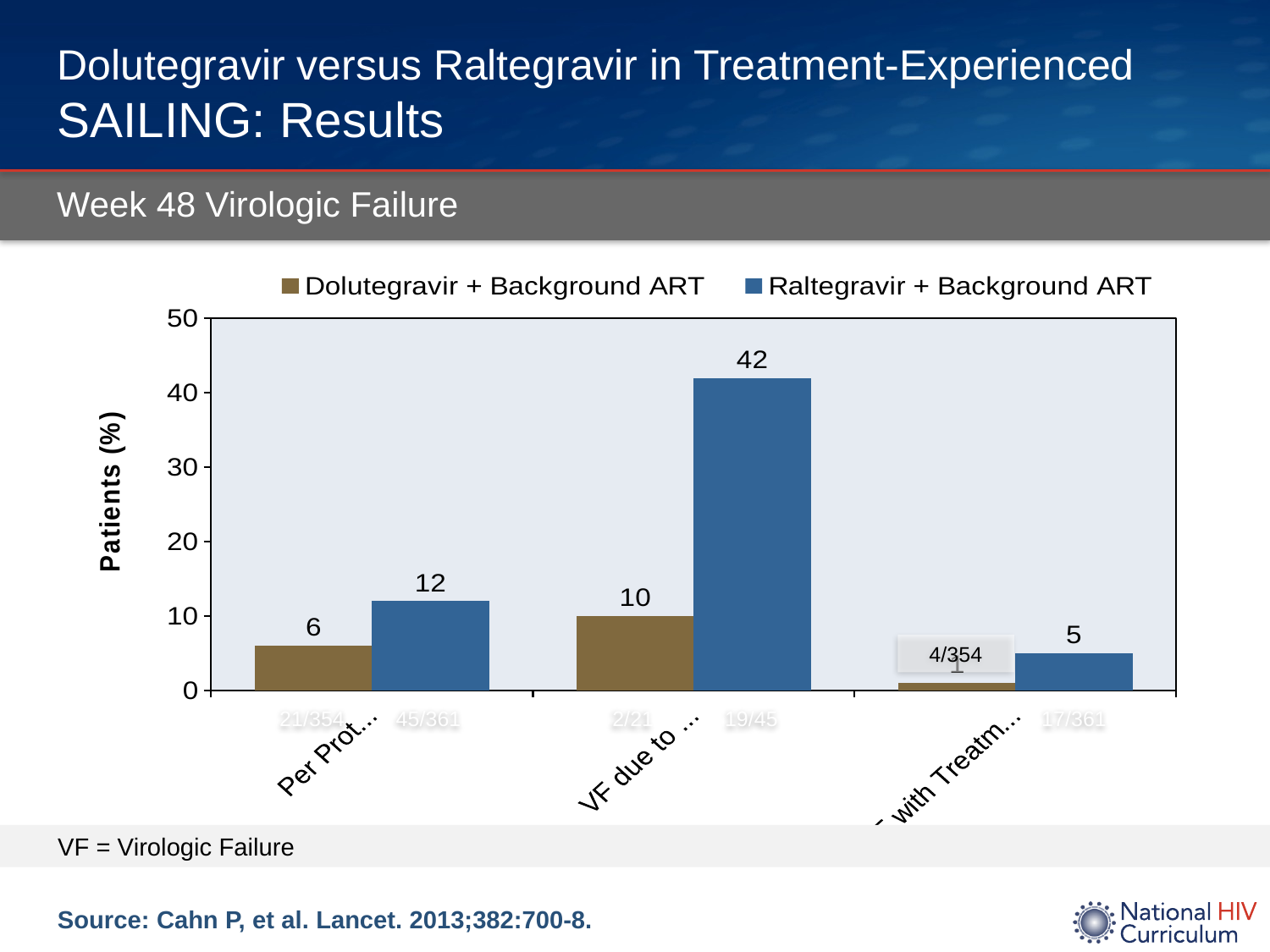
In the middle group of bars, what is the difference between the Raltegravir + Background ART value and the Dolutegravir + Background ART value? 32 What is the value for Raltegravir + Background ART in the leftmost group of bars? 12 What is the value for Dolutegravir + Background ART in the middle group of bars? 10 What is the title of the y axis? Patients (%) Which bar has the highest value on the chart? Raltegravir + Background ART in the middle group (42) In the leftmost group of bars, which series has the larger value? Raltegravir + Background ART How many series does the chart legend list? 2 What is the value for Dolutegravir + Background ART in the leftmost group of bars? 6 What is the value for Raltegravir + Background ART in the middle group of bars? 42 What kind of chart is shown on the slide? Bar chart What is the value for Raltegravir + Background ART in the rightmost group of bars? 5 How many groups of bars (categories) are plotted on the x axis? 3